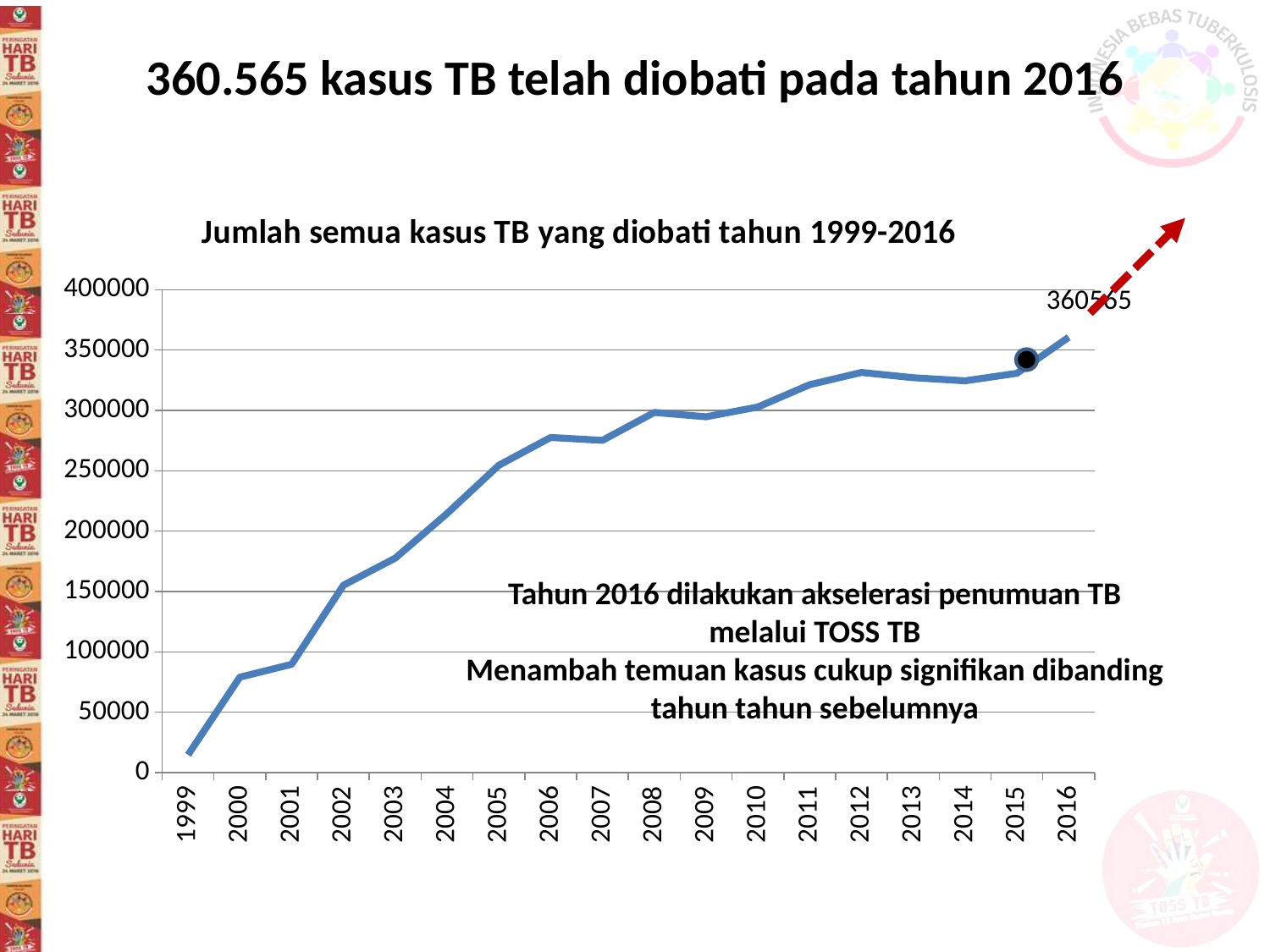
How many years are plotted on the x axis? 18 Which year has the larger value, 2003 or 2004? 2004 Which year has the highest number of treated TB cases? 2016 Is the value for 2011 greater or less than 300000? greater What is the title of the chart? Jumlah semua kasus TB yang diobati tahun 1999-2016 Which year has the lowest number of treated TB cases? 1999 Is the value for 1999 greater or less than 50000? less What type of chart is shown on the slide? line chart Is the value for 2003 greater or less than 150000? greater What is the value shown for 2016? 360565 Do the values generally rise or fall from 1999 to 2016? rise Which year has the larger value, 2009 or 2012? 2012